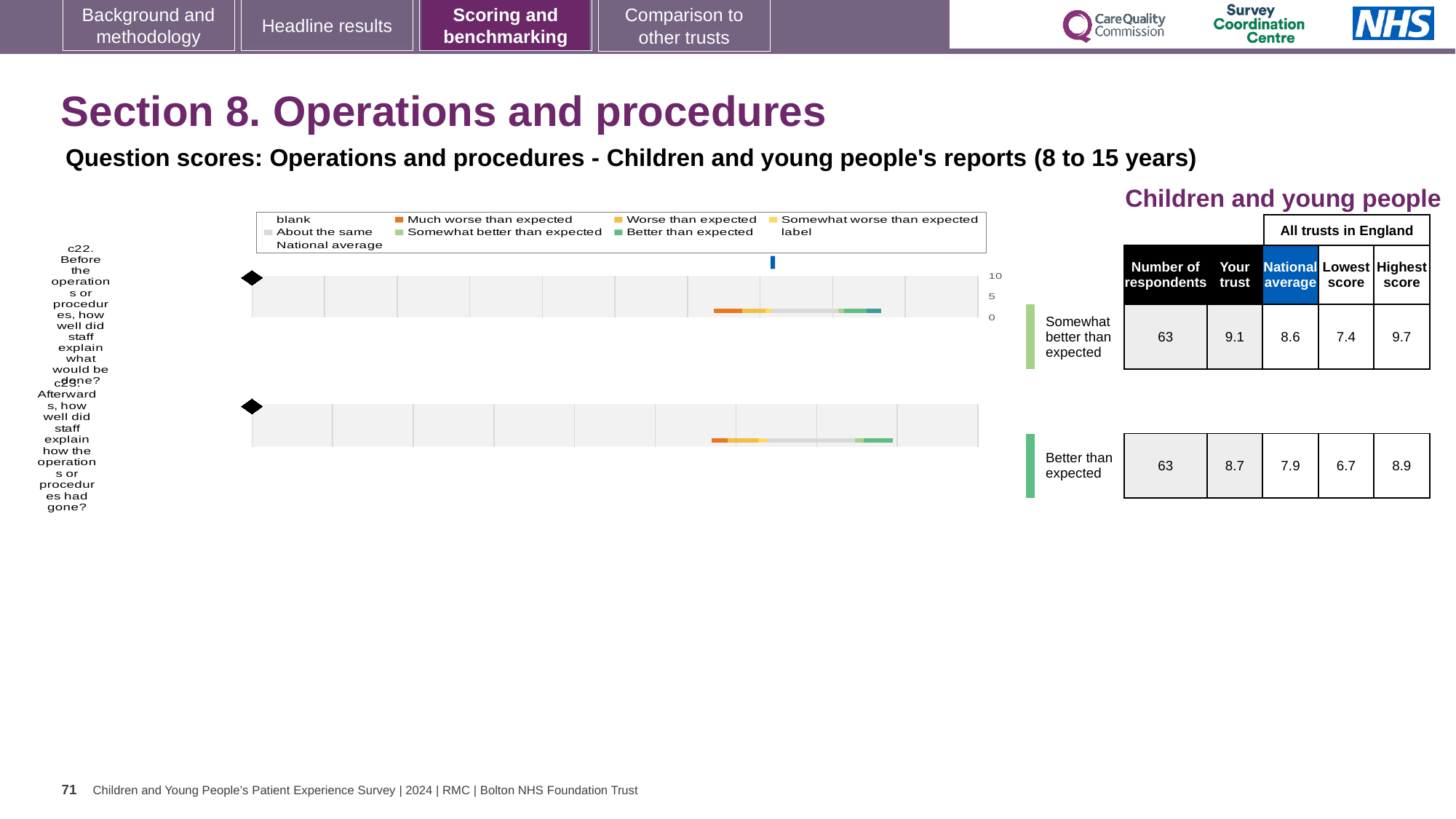
What is the national average score for question c23 (Afterwards, how well did staff explain how the operations or procedures had gone?)? 7.9 Which benchmark category is question c23 assigned to? Better than expected What is the highest score among all trusts in England for question c22? 9.7 What colour does the chart legend use for 'Much worse than expected'? orange What is the lowest score among all trusts in England for question c23? 6.7 How many respondents answered question c22? 63 What is the 'Your trust' score for question c22 (Before the operations or procedures, how well did staff explain what would be done?)? 9.1 What kind of chart is shown on the slide? bar chart Which question has the higher 'Your trust' score, c22 or c23? c22 How many survey questions (categories) are plotted in the chart? 2 What is the difference between the 'Your trust' scores for c22 and c23? 0.4